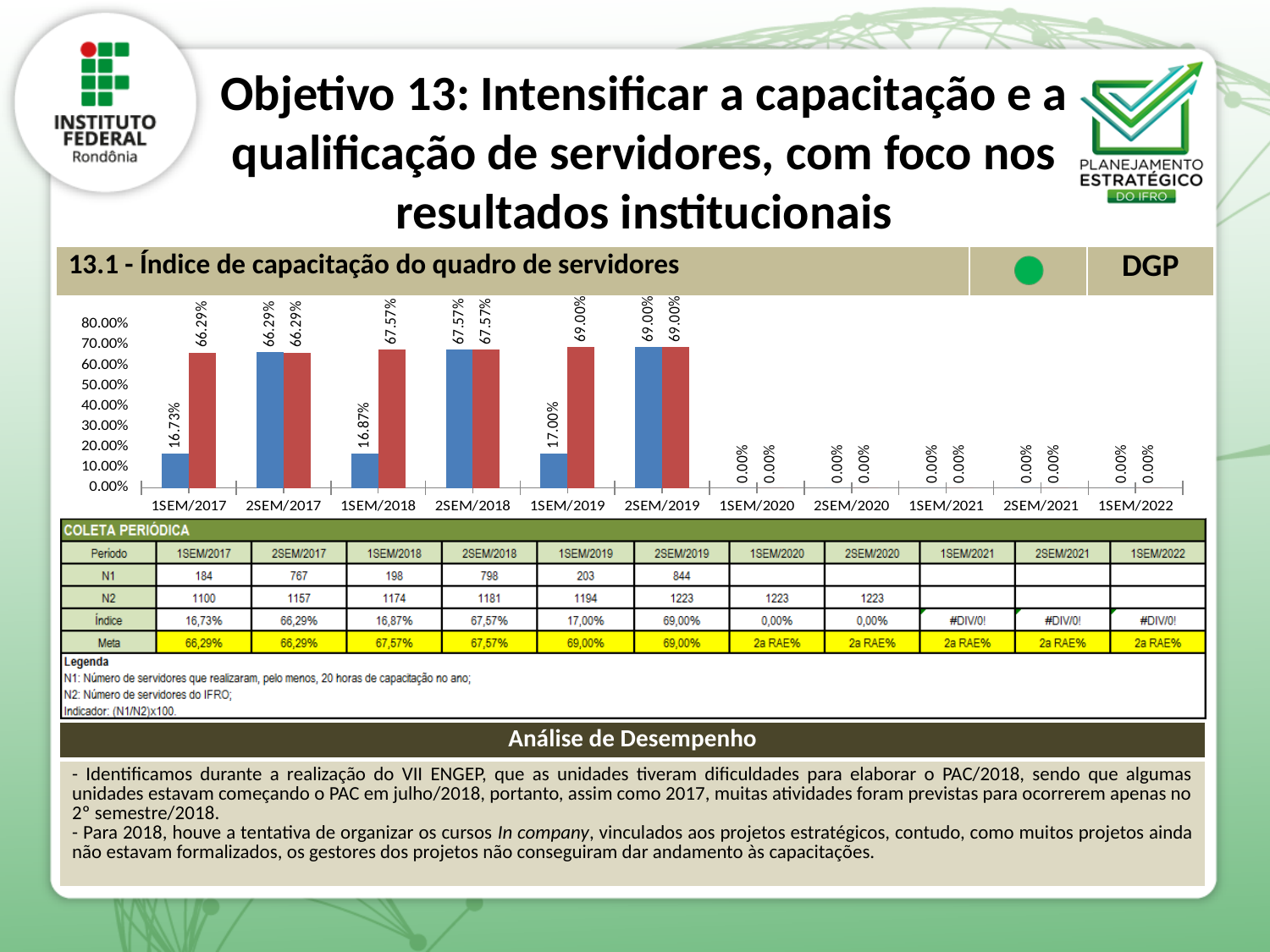
What value is shown for both bars in 1SEM/2020? 0.00% What is the value of the blue bar for 1SEM/2017? 16.73% What type of chart is shown on the slide? bar chart What is the value of the blue bar for 2SEM/2019? 69.00% How many periods are shown on the x axis of the chart? 11 What is the highest value shown on the y axis of the chart? 80.00% Which period has the highest blue bar value? 2SEM/2019 Which is larger for 1SEM/2019, the blue bar or the red bar? the red bar What is the difference between the red bar and the blue bar for 1SEM/2018? 50.70% What is the value of the blue bar for 1SEM/2019? 17.00% What is the value of the red bar for 1SEM/2018? 67.57% Is the blue bar value for 2SEM/2018 greater or less than 60.00%? greater